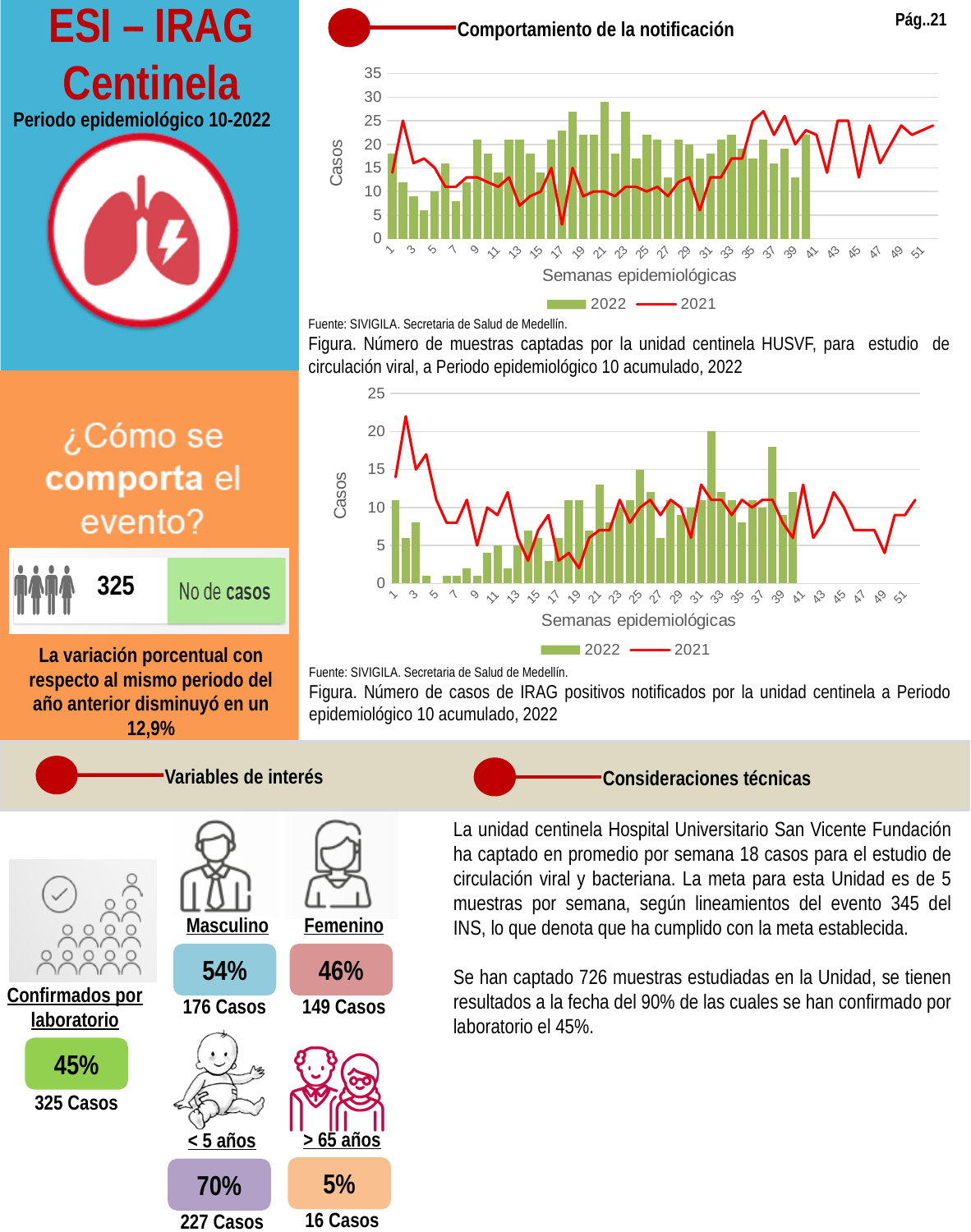
In the top chart (Número de muestras captadas), is the 2022 value for week 4 greater or less than 10? less In the top chart (Número de muestras captadas), is the 2022 value for week 21 greater or less than 25? greater In the top chart (Número de muestras captadas), which series is drawn as a red line? 2021 In the top chart (Número de muestras captadas), which epidemiological week has the highest 2022 bar? 21 In the bottom chart (Número de casos de IRAG positivos), is the 2022 value for week 5 greater or less than 5? less In the top chart (Número de muestras captadas), how many series does the legend list? 2 In the bottom chart (Número de casos de IRAG positivos), how many series does the legend list? 2 In the bottom chart (Número de casos de IRAG positivos), at week 2, which series has the larger value, 2021 or 2022? 2021 In the bottom chart (Número de casos de IRAG positivos), which epidemiological week has the highest 2022 bar? 32 In the top chart (Número de muestras captadas), what is the highest value shown on the vertical axis? 35 In the top chart (Número de muestras captadas por la unidad centinela HUSVF), what kind of chart is used to show the 2022 series? Bar chart